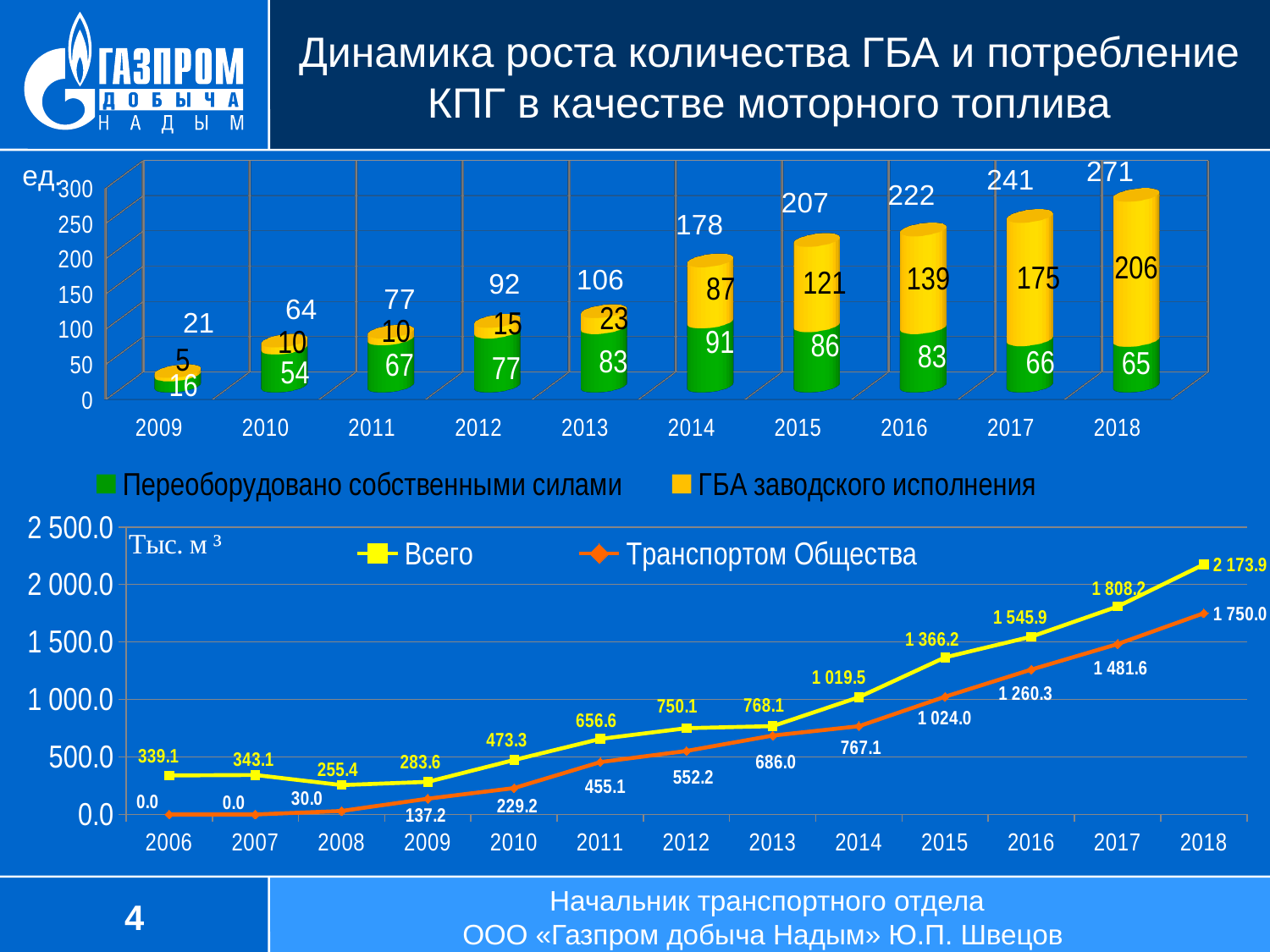
In the top bar chart, what is the difference between the 'ГБА заводского исполнения' values for 2018 and 2017? 31 In the top bar chart, what is the total number of units shown for 2018? 271 In the bottom line chart, what is the value of 'Транспортом Общества' for 2018? 1 750.0 In the bottom line chart, which year has the lowest value for 'Всего'? 2008 In the top bar chart, what is the value of 'ГБА заводского исполнения' for 2015? 121 What kind of chart is the bottom chart on the slide? Line chart In the bottom line chart, what is the difference between 'Всего' and 'Транспортом Общества' in 2016? 285.6 In the bottom line chart, what is the value of 'Всего' for 2015? 1 366.2 In the top bar chart, how many series does the legend list? 2 In the top bar chart, how many years are shown on the x axis? 10 In the top bar chart, which year has the highest value for 'Переоборудовано собственными силами'? 2014 In the top bar chart, what is the value of 'Переоборудовано собственными силами' for 2014? 91